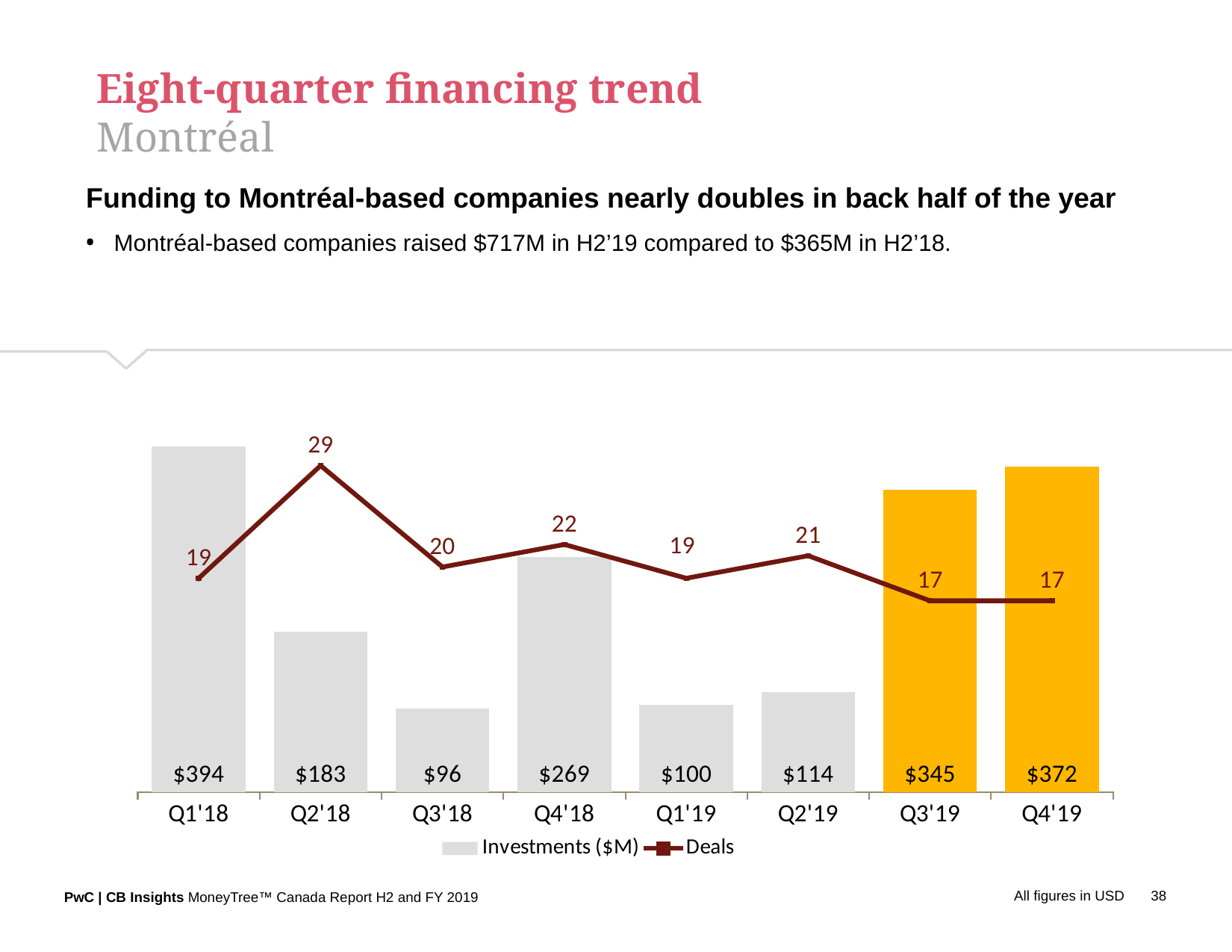
What is the difference in Investments ($M) between Q4'19 and Q3'19? $27 Which quarter has the highest number of deals? Q2'18 How many series does the legend list? 2 Do the Investments ($M) values rise or fall from Q1'19 to Q4'19? Rise What is the Investments ($M) value for Q4'19? $372 How many deals were recorded in Q2'18? 29 What is the Investments ($M) value for Q1'18? $394 Which quarter has the lowest Investments ($M) value? Q3'18 How many quarters are shown on the x axis? 8 What kind of chart is used to show the Investments ($M) series? Bar chart Which is larger, the Investments ($M) value for Q4'18 or for Q2'19? Q4'18 Which quarter has the highest Investments ($M) value? Q1'18